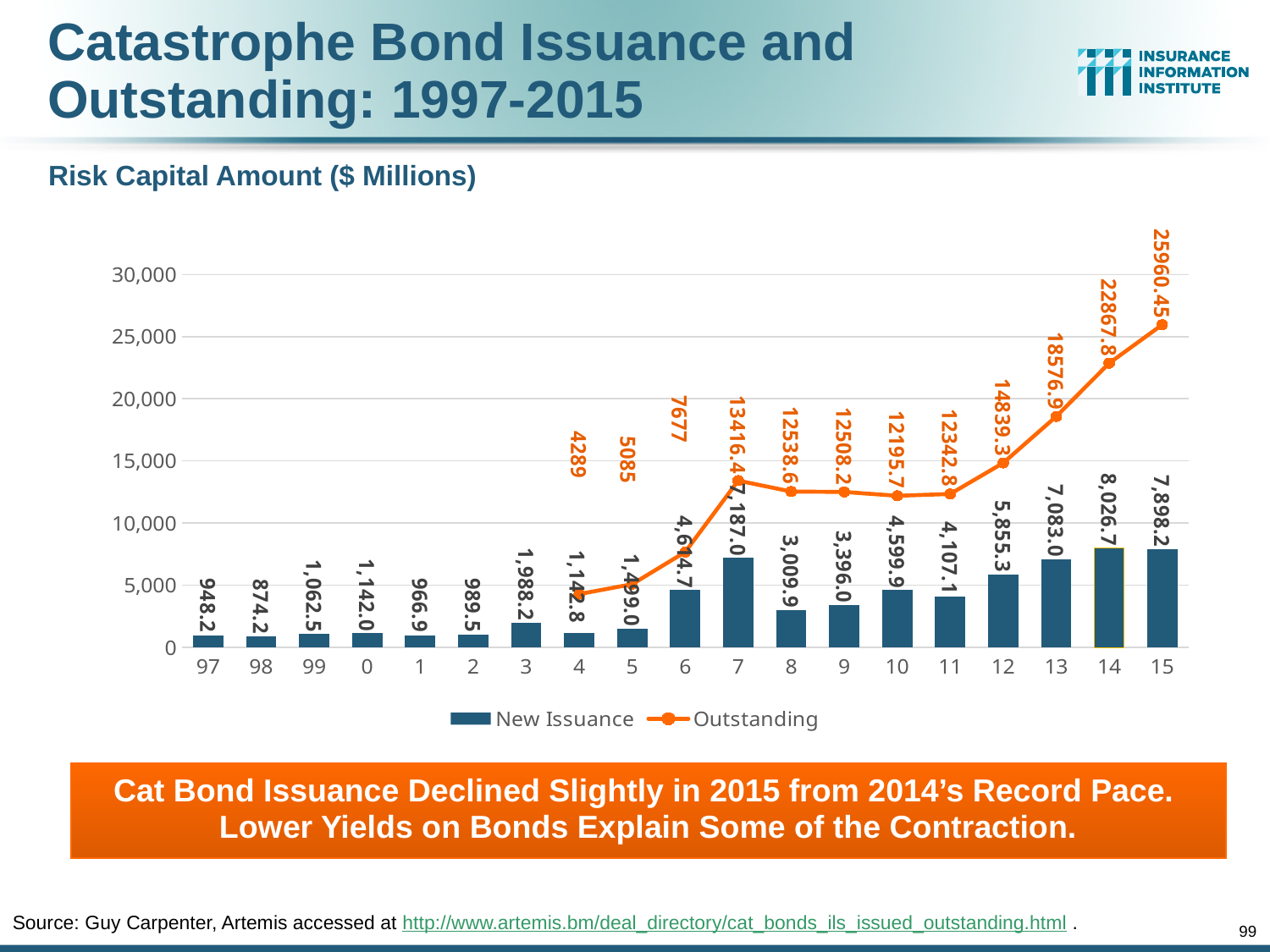
Which is larger, the New Issuance value for 2007 (label 7) or for 2013 (label 13)? 2007 (7,187.0) What is the Outstanding value for 2015 (label 15)? 25960.45 How many years are shown on the x axis? 19 What is the New Issuance value for 1997 (label 97)? 948.2 How many series does the legend list? 2 What is the Outstanding value for 2007 (label 7)? 13416.4 By how much did New Issuance fall from 2014 (label 14) to 2015 (label 15)? 128.5 Which year has the highest New Issuance value? 14 Which year has the lowest New Issuance value? 98 What is the New Issuance value for 2014 (label 14)? 8,026.7 Is the Outstanding value for 2013 (label 13) greater or less than 15,000? greater Does the Outstanding line rise or fall from 2012 (label 12) to 2015 (label 15)? rise